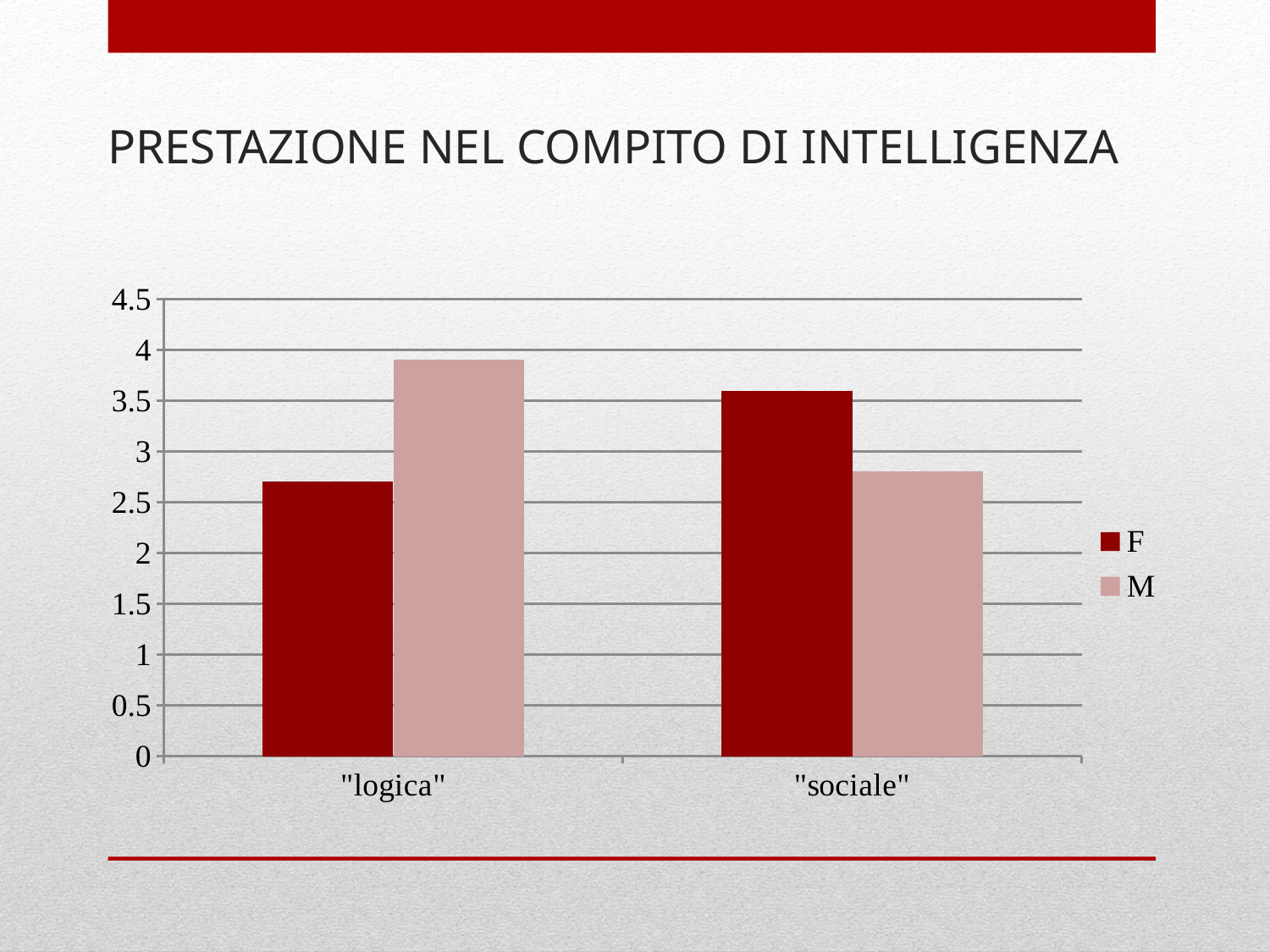
Is the value for M in "sociale" greater or less than 3? less How many categories are shown on the x axis? 2 Which series is shown in dark red? F In the "logica" category, which series has the larger value, F or M? M Is the value for F in "sociale" greater or less than 3? greater Which bar is the highest in the chart? M in "logica" Is the value for M in "logica" greater or less than 3.5? greater In the "sociale" category, which series has the larger value, F or M? F How many series does the legend list? 2 What is the title of the slide? PRESTAZIONE NEL COMPITO DI INTELLIGENZA What kind of chart is shown on the slide? bar chart